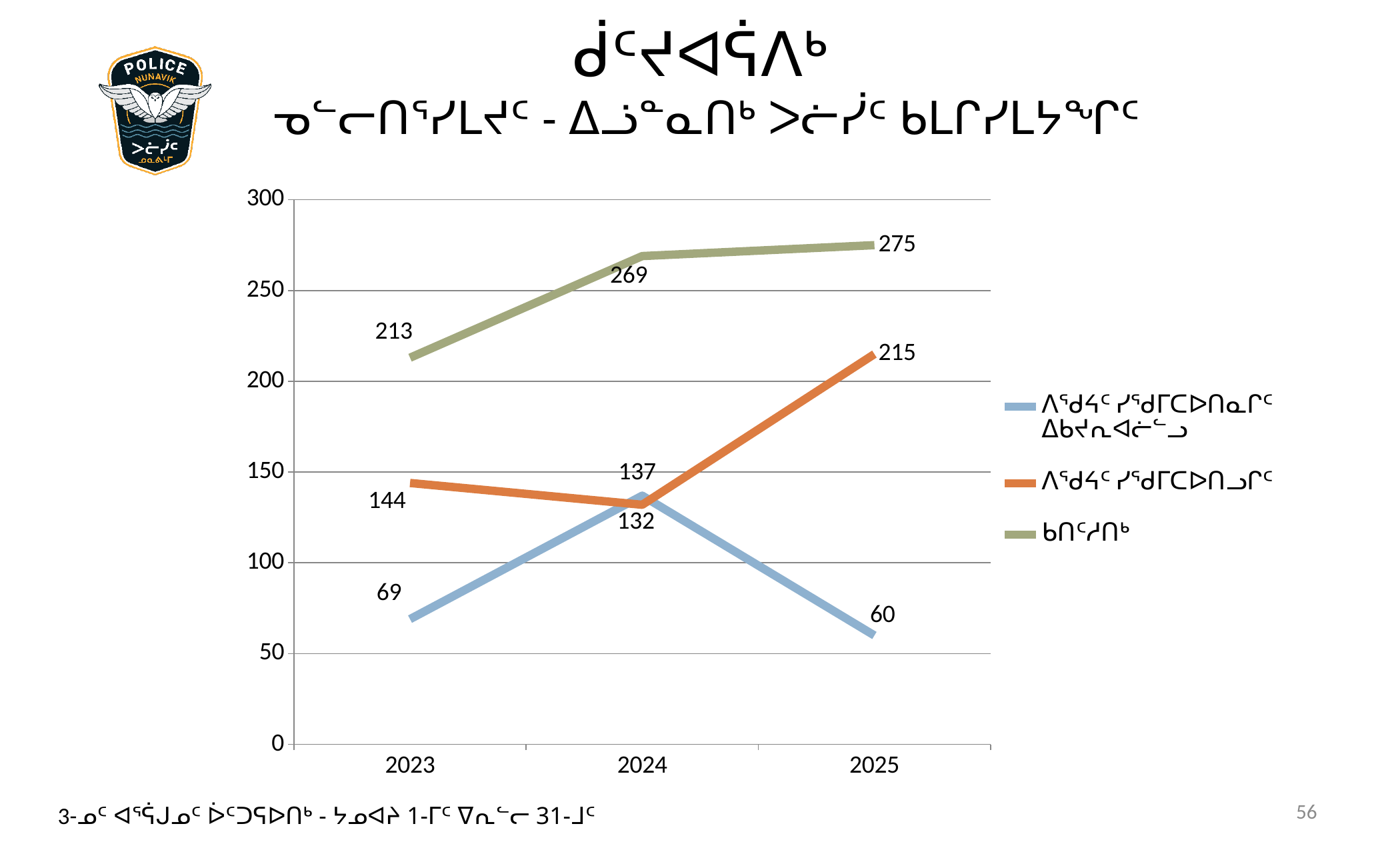
What kind of chart is shown on the slide? line chart Is the value of the green line in 2023 greater or less than 200? greater In which year does the blue line have its lowest value? 2025 How many series does the legend list? 3 By how much did the orange line increase from 2024 to 2025? 83 What is the value of the green line in 2025? 275 What is the difference between the green line's values in 2024 and 2023? 56 What is the value of the blue line in 2024? 137 In 2024, which line has the higher value, the blue line or the orange line? the blue line In which year does the green line reach its highest value? 2025 What is the value of the orange line in 2023? 144 How many years are shown on the x axis? 3